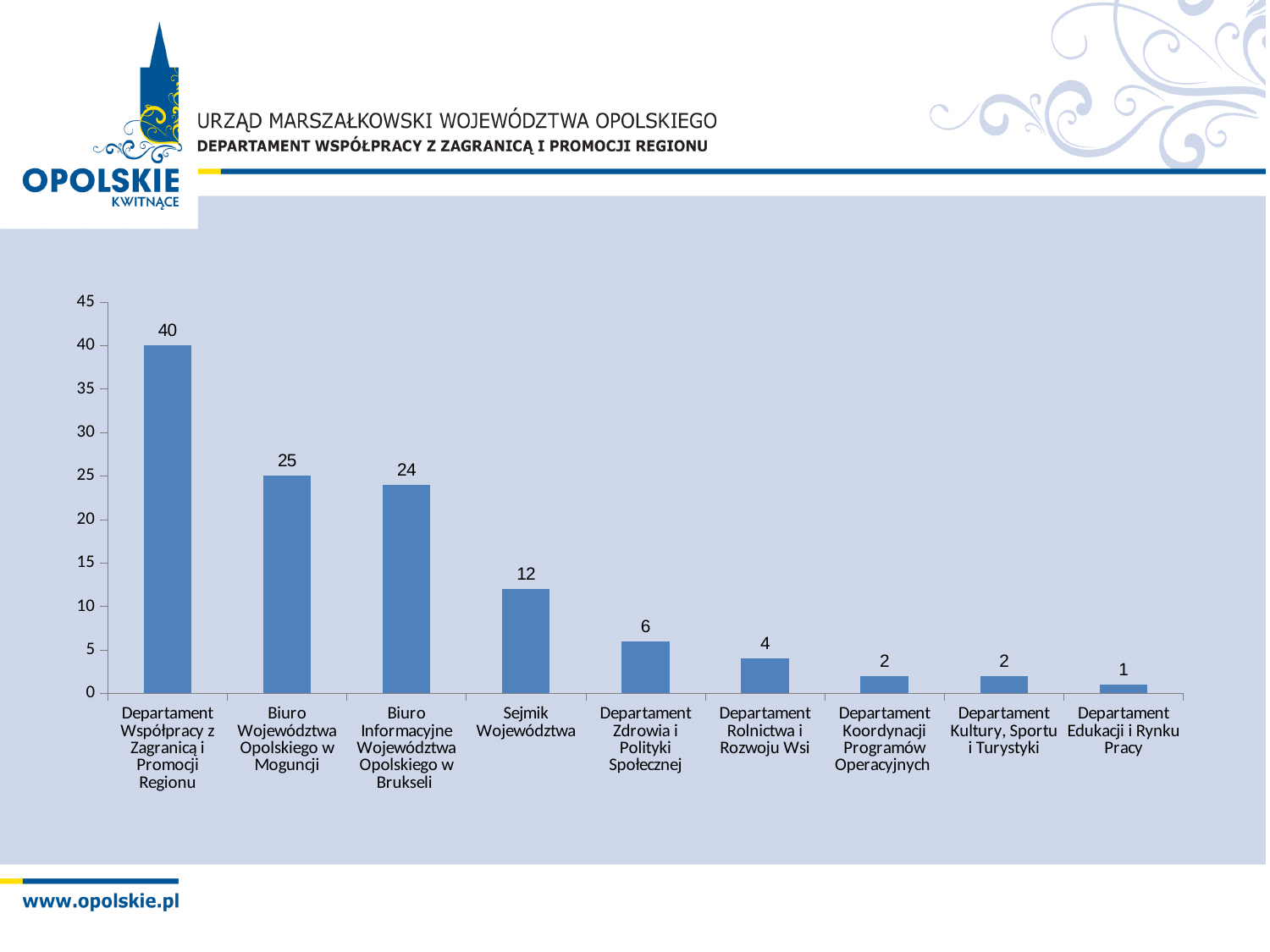
Which category has the lowest value? Departament Edukacji i Rynku Pracy Which is larger, the value for Biuro Województwa Opolskiego w Moguncji or the value for Biuro Informacyjne Województwa Opolskiego w Brukseli? Biuro Województwa Opolskiego w Moguncji Is the value for Departament Współpracy z Zagranicą i Promocji Regionu greater or less than 35? greater Which category has the highest value? Departament Współpracy z Zagranicą i Promocji Regionu What is the value for Biuro Informacyjne Województwa Opolskiego w Brukseli? 24 What is the value for Sejmik Województwa? 12 What is the difference between the values for Sejmik Województwa and Departament Rolnictwa i Rozwoju Wsi? 8 What is the value for Departament Zdrowia i Polityki Społecznej? 6 How many categories are shown on the x axis? 9 Do the values rise or fall from left to right along the x axis? fall What kind of chart is shown on the slide? bar chart What is the difference between the values for Departament Współpracy z Zagranicą i Promocji Regionu and Biuro Województwa Opolskiego w Moguncji? 15